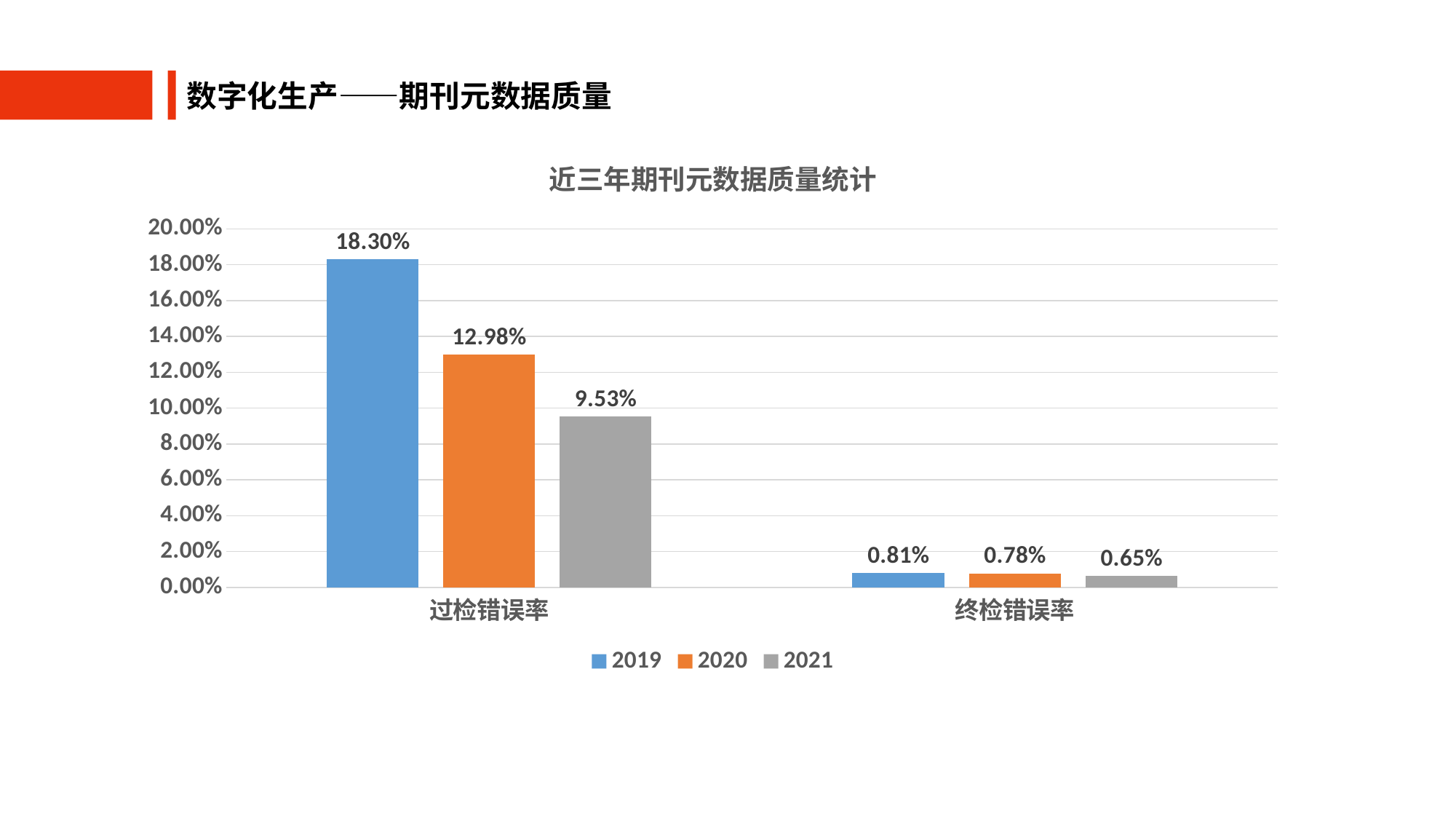
Which year has the lowest 终检错误率? 2021 What is the difference between the 2019 and 2021 values for 过检错误率? 8.77% What is the 2021 value for 终检错误率? 0.65% What is the 2020 value for 过检错误率? 12.98% Which year has the highest 过检错误率? 2019 How many series does the legend list? 3 Do the 过检错误率 values rise or fall from 2019 to 2021? Fall Which is larger: the 2020 value for 过检错误率 or the 2021 value for 过检错误率? 2020 What is the 2019 value for 过检错误率? 18.30% What kind of chart is shown? Bar chart What is the title of the chart? 近三年期刊元数据质量统计 How many categories are shown on the x axis? 2